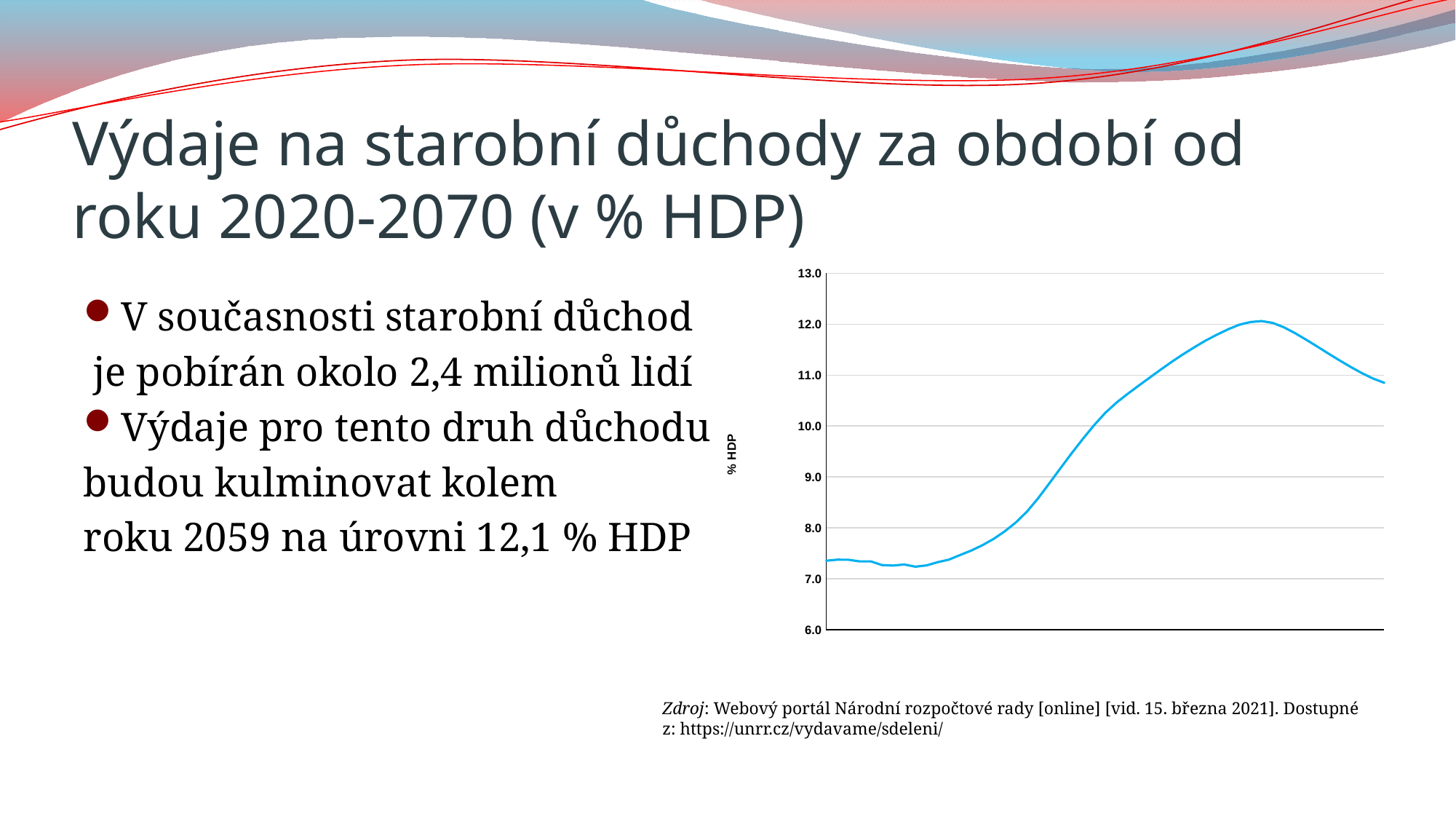
What is the highest value shown on the vertical axis of the chart? 13.0 Is the value at the start of the line (left end) greater or less than 8.0? less Does the line rise or fall over the first half of the x axis? rise Is the value at the end of the line (right end) greater or less than 10.0? greater How many lines are plotted on the chart? 1 What is the label on the vertical axis of the chart? % HDP Is the value at the start of the line (left end) greater or less than 7.0? greater Does the line rise or fall after reaching its peak? fall Which is larger: the value at the left end of the line or the value at the right end of the line? the right end What kind of chart is shown on the slide? line chart